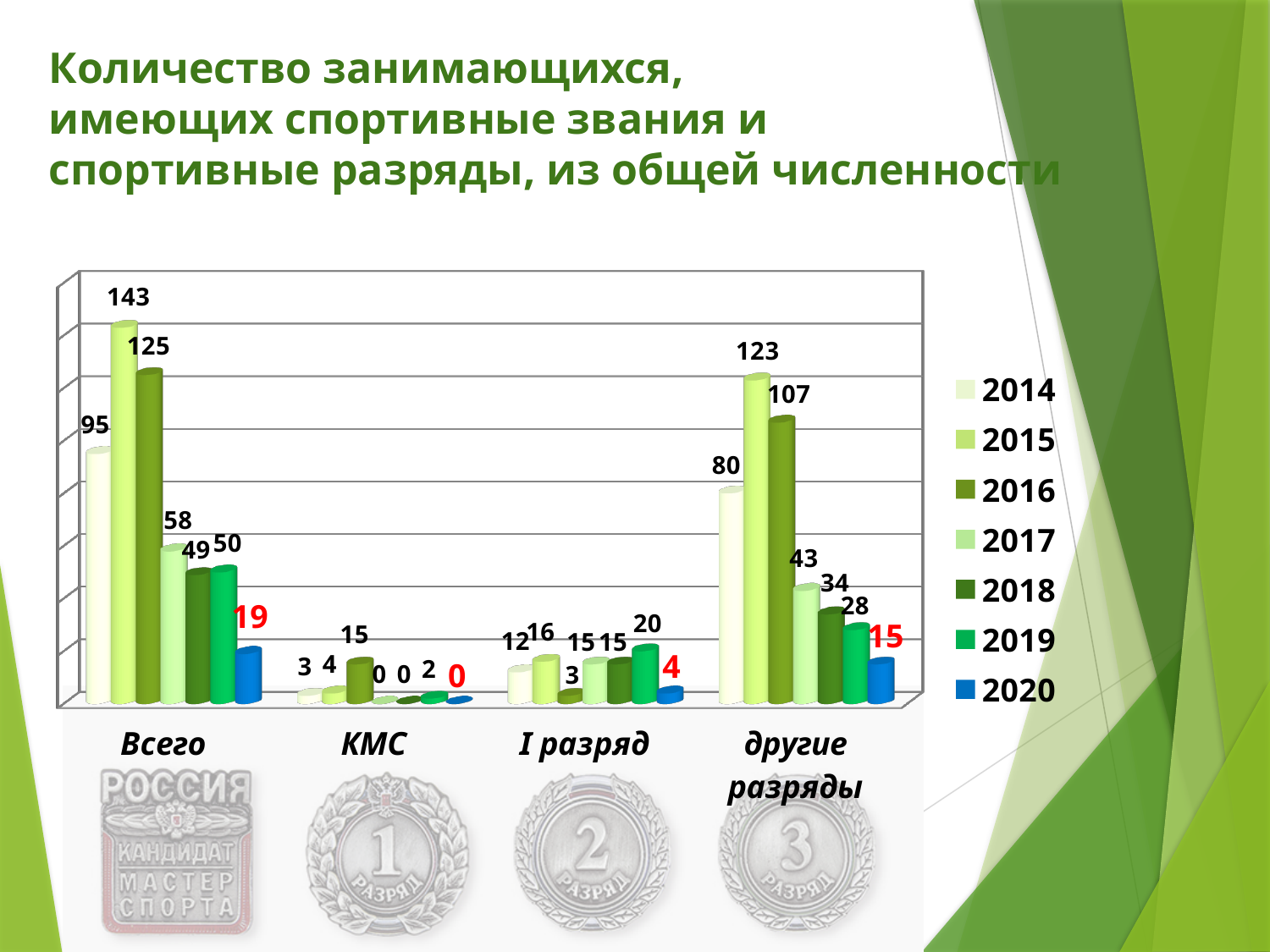
How many series does the legend list? 7 Which is larger in the I разряд category: the value for 2014 or the value for 2015? 2015 What kind of chart is shown on the slide? Bar chart Which year has the highest value in the другие разряды category? 2015 How many categories are shown on the x axis? 4 What is the value for 2020 in the другие разряды category? 15 Which years are listed in the legend? 2014, 2015, 2016, 2017, 2018, 2019, 2020 What is the value for 2016 in the КМС category? 15 What is the difference between the 2015 and 2016 values in the Всего category? 18 What is the value for 2019 in the I разряд category? 20 What is the value for 2015 in the Всего category? 143 Which year has the lowest value in the Всего category? 2020